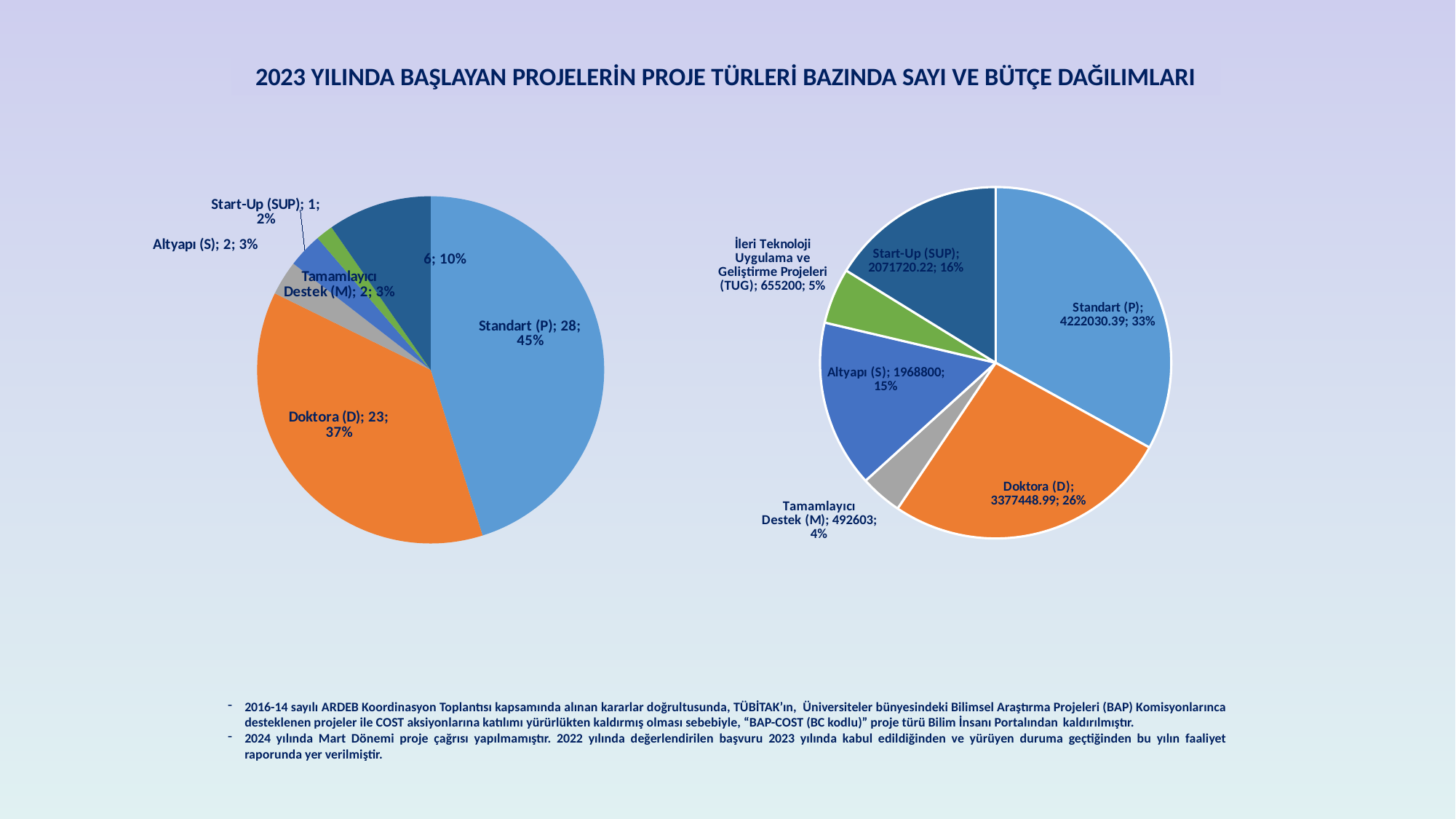
In the left pie chart, which project type has the smallest slice? Start-Up (SUP) In the right pie chart, which project type has the largest budget share? Standart (P) In the right pie chart, what share of the budget does Start-Up (SUP) have? 16% In the right pie chart, which project type has the smallest budget share? Tamamlayıcı Destek (M) In the right pie chart, what is the budget value shown for İleri Teknoloji Uygulama ve Geliştirme Projeleri (TUG)? 655200 What type of chart is used for the two charts on the slide? Pie chart In the left pie chart, which project type has the largest slice? Standart (P) In the left pie chart, how many more Standart (P) projects are there than Doktora (D) projects? 5 In the right pie chart, what is the budget value shown for Altyapı (S)? 1968800 In the left pie chart, what share of the projects is Doktora (D)? 37% In the right pie chart, which has the larger budget, Altyapı (S) or Start-Up (SUP)? Start-Up (SUP) In the left pie chart, how many Standart (P) projects are shown? 28